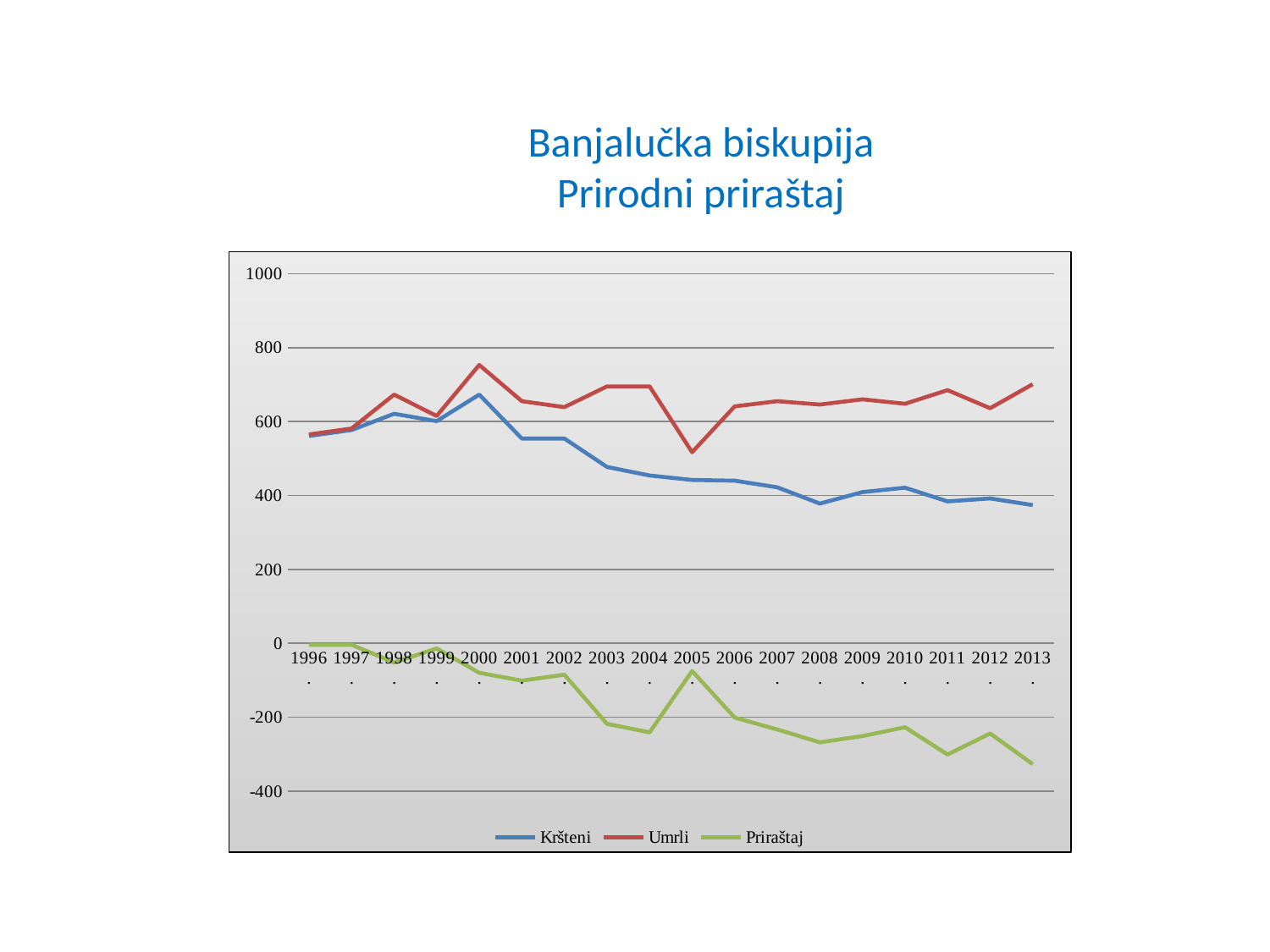
How many series does the legend list? 3 In which year does the Umrli series reach its lowest value? 2005 Does the Kršteni series generally rise or fall from 2000 to 2013? fall How many years are plotted along the x axis? 18 In which year does the Umrli series reach its highest value? 2000 Is the value for Priraštaj in 2013 greater or less than -200? less What kind of chart is shown on the slide? line chart In which year does the Priraštaj series reach its lowest value? 2013 Is the value for Kršteni in 2000 greater or less than 600? greater In which year does the Kršteni series reach its highest value? 2000 Is the value for Umrli in 2005 greater or less than 600? less In 2013, which is larger, Umrli or Kršteni? Umrli